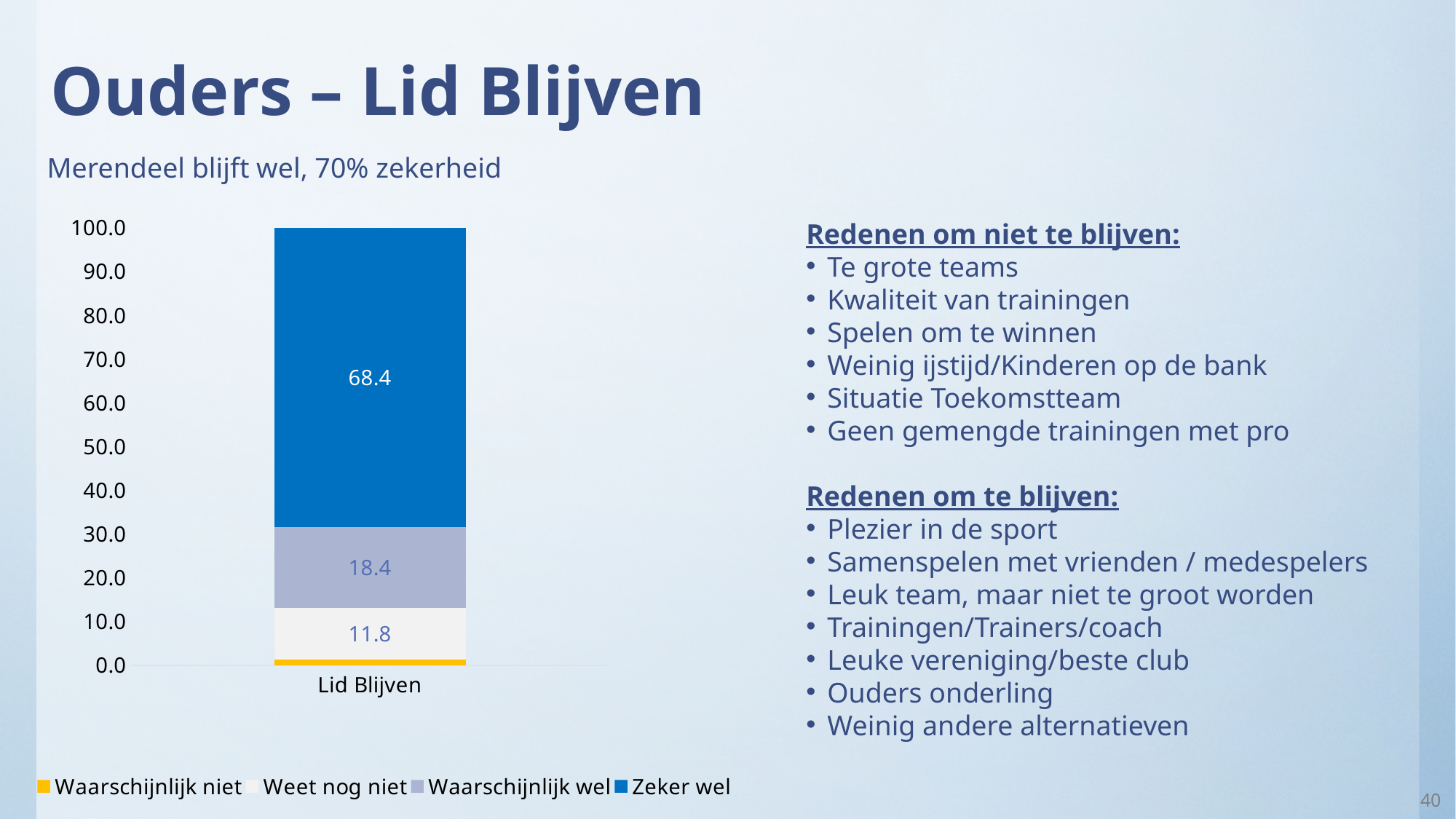
Is the value for 'Waarschijnlijk niet' greater or less than 10.0? less What kind of chart is shown on the slide? Stacked bar chart Which series has the largest segment in the 'Lid Blijven' bar? Zeker wel Which is larger, the 'Weet nog niet' segment or the 'Waarschijnlijk wel' segment? Waarschijnlijk wel What is the difference between the 'Waarschijnlijk wel' and 'Weet nog niet' values? 6.6 What is the value of the 'Weet nog niet' segment in the 'Lid Blijven' bar? 11.8 What is the value of the 'Zeker wel' segment in the 'Lid Blijven' bar? 68.4 What is the value of the 'Waarschijnlijk wel' segment in the 'Lid Blijven' bar? 18.4 What is the difference between the 'Zeker wel' and 'Waarschijnlijk wel' values? 50.0 Which series has the smallest segment in the 'Lid Blijven' bar? Waarschijnlijk niet How many categories are shown on the x axis of the chart? 1 How many series does the chart legend list? 4